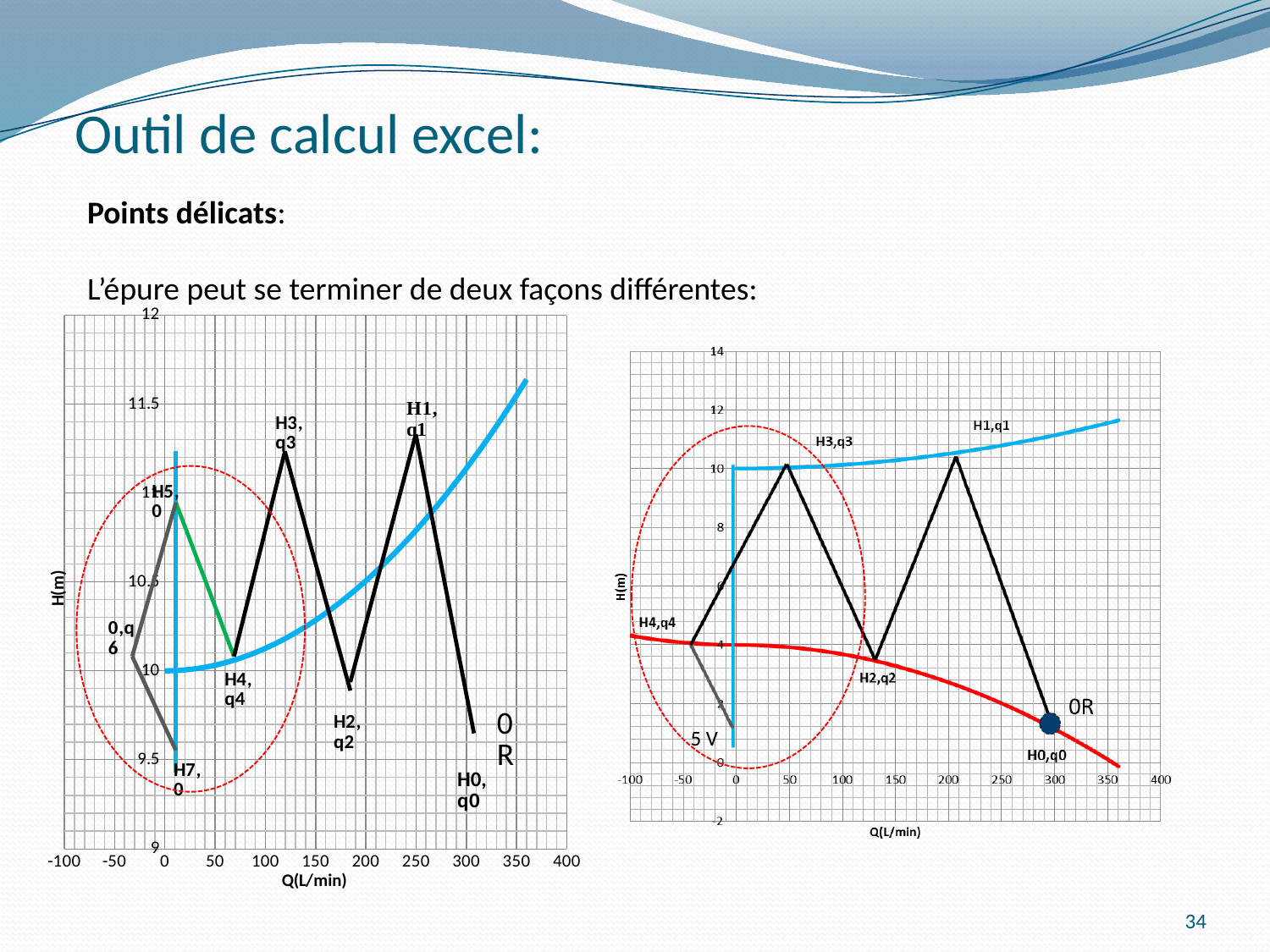
On the left chart, is the value for the point H3,q3 greater or less than 11? greater On the left chart, is the value for the point H0,q0 greater or less than 10? less On the left chart, which point is higher, H3,q3 or H2,q2? H3,q3 On the right chart, which point is higher, H1,q1 or H2,q2? H1,q1 On the left chart, is the value for the point H2,q2 greater or less than 10? less What is the label of the horizontal axis on the left chart? Q(L/min) What kind of chart is the left chart on the slide? line chart On the right chart, does the red curve rise or fall as Q increases from 0 to 350? fall What is the label of the vertical axis on the right chart? H(m)